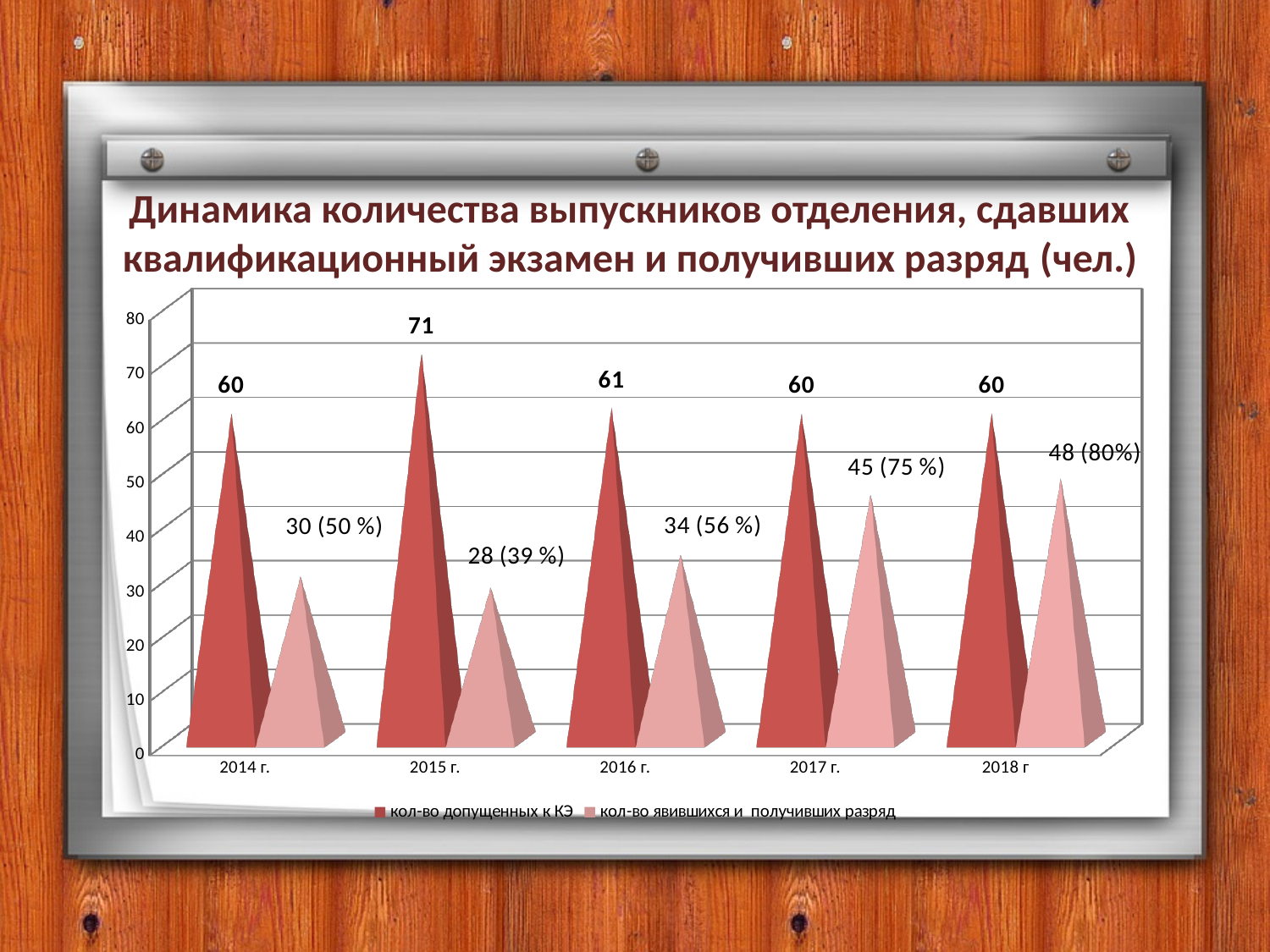
What kind of chart is shown on the slide? bar chart How many series does the legend list? 2 What is the value for 'кол-во допущенных к КЭ' in 2015 г.? 71 How many years are shown on the x axis? 5 Does 'кол-во явившихся и получивших разряд' rise or fall from 2015 г. to 2018 г? rise In which year is 'кол-во допущенных к КЭ' highest? 2015 г. In which year is 'кол-во явившихся и получивших разряд' lowest? 2015 г. Is the value for 'кол-во явившихся и получивших разряд' in 2018 г greater or less than 40? greater What is the difference between 'кол-во допущенных к КЭ' and 'кол-во явившихся и получивших разряд' in 2017 г.? 15 Which is larger: 'кол-во явившихся и получивших разряд' in 2016 г. or in 2014 г.? 2016 г. What is the data label for 'кол-во явившихся и получивших разряд' in 2018 г? 48 (80%) What is the data label for 'кол-во явившихся и получивших разряд' in 2015 г.? 28 (39 %)